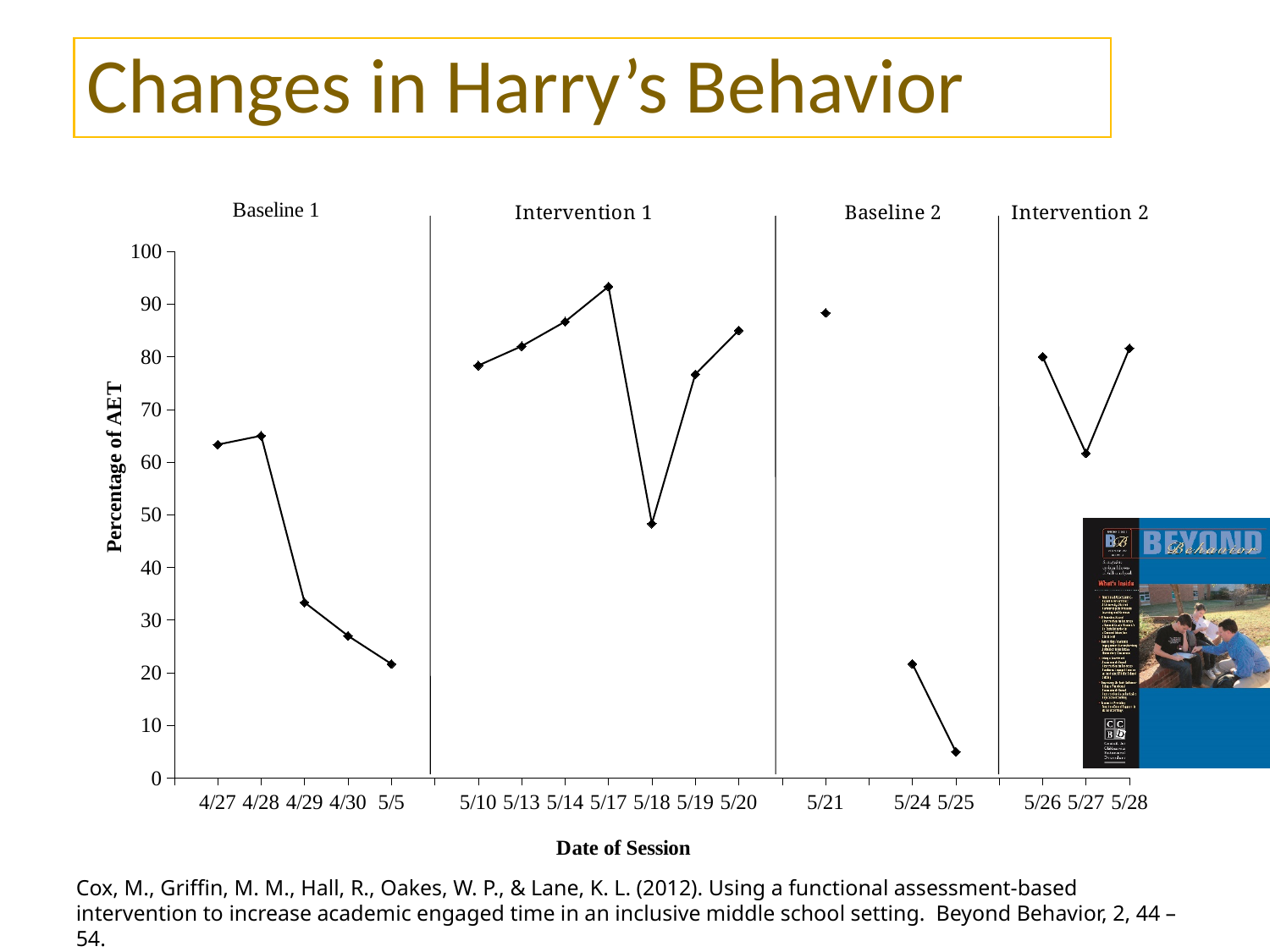
On which date is the percentage of AET lowest? 5/25 What is the title of the y axis? Percentage of AET Do the values rise or fall across the Baseline 1 phase from 4/27 to 5/5? fall Which has the higher percentage of AET, 4/28 or 4/29? 4/28 Is the value for 4/27 greater or less than 60? greater What kind of chart is shown on the slide? line chart Is the value for 5/5 greater or less than 30? less On which date is the percentage of AET highest? 5/17 Is the value for 5/21 greater or less than 80? greater What is the title of the x axis? Date of Session How many session dates are plotted on the x axis? 18